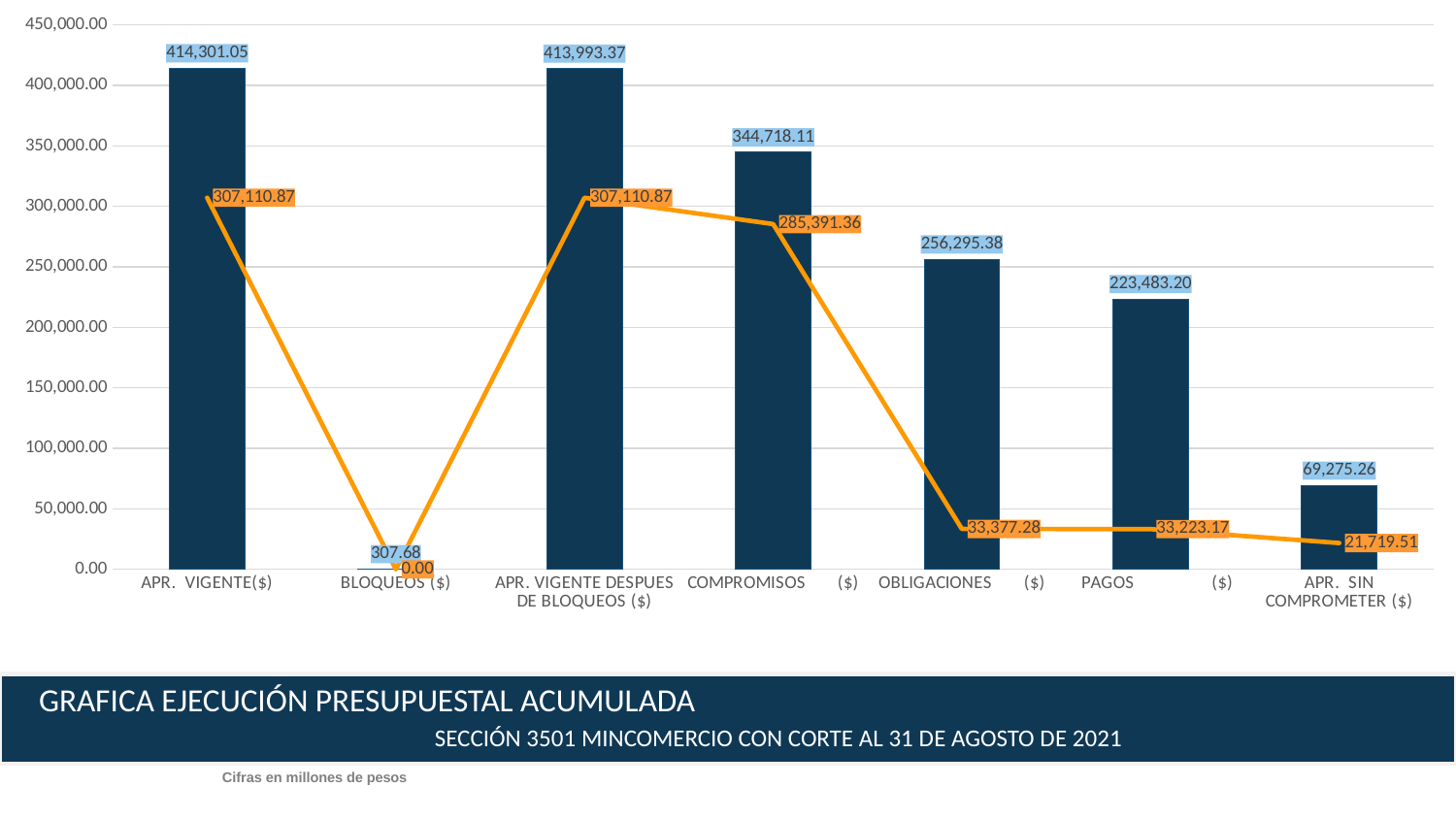
Is the bar value for COMPROMISOS ($) greater or less than 300,000.00? greater What is the value of the bar for APR. SIN COMPROMETER ($)? 69,275.26 What value does the orange line show for PAGOS ($)? 33,223.17 Which has the larger bar value, OBLIGACIONES ($) or PAGOS ($)? OBLIGACIONES ($) What kind of chart is shown on the slide? A bar chart combined with a line chart What is the title of the chart shown on the slide? GRAFICA EJECUCIÓN PRESUPUESTAL ACUMULADA How many categories are shown on the x axis? 7 What value does the orange line show for OBLIGACIONES ($)? 33,377.28 What is the value of the bar for COMPROMISOS ($)? 344,718.11 Which category has the lowest bar value? BLOQUEOS ($) What is the difference between the bar value and the orange line value for COMPROMISOS ($)? 59,326.75 What is the difference between the bar values for APR. VIGENTE($) and APR. VIGENTE DESPUES DE BLOQUEOS ($)? 307.68